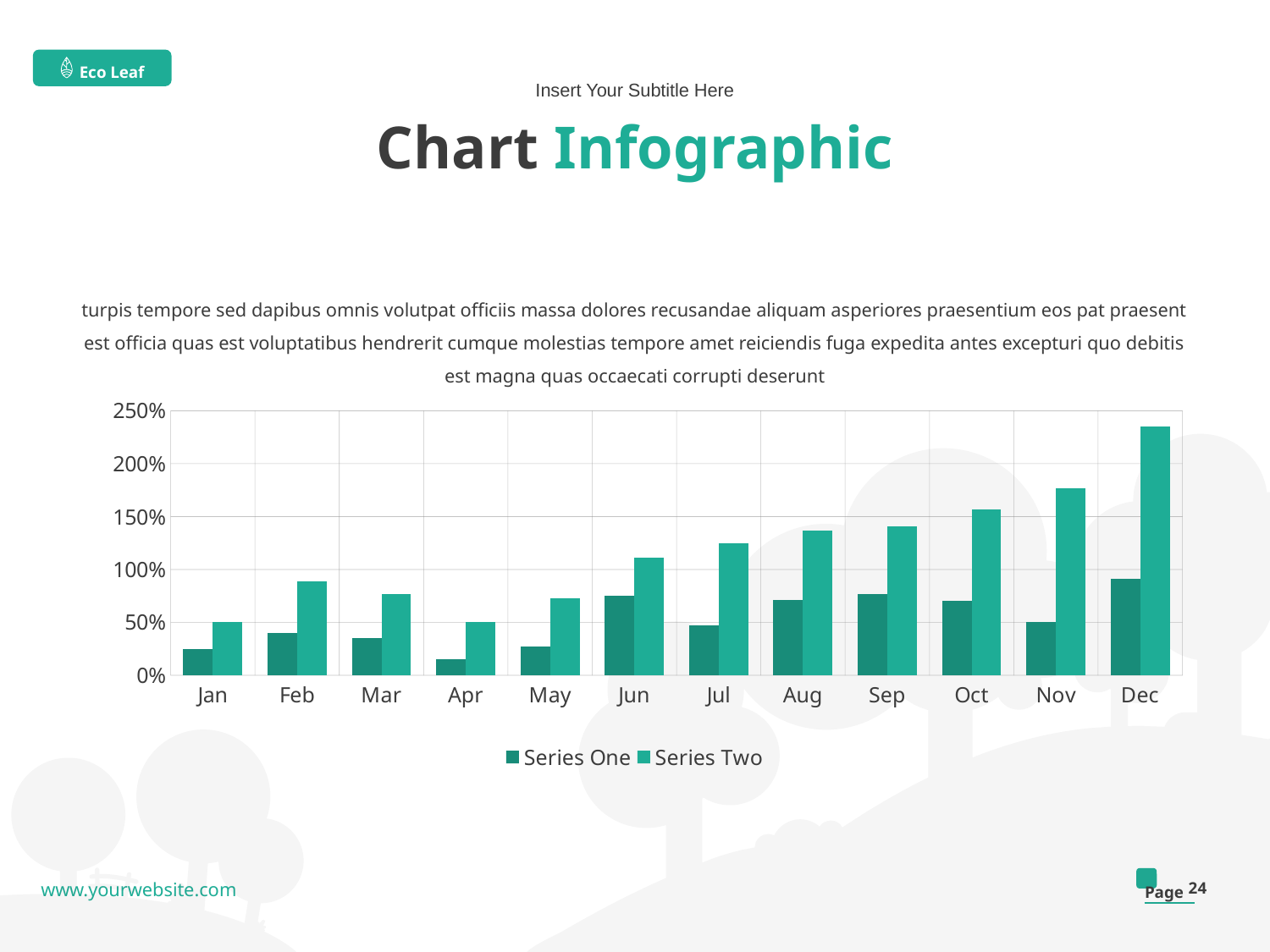
How many series does the legend list? 2 How many categories (months) are shown on the x axis? 12 Is the value for Series Two in Nov greater or less than 150%? greater Which month has the highest value for Series Two? Dec What are the two entries in the chart legend? Series One and Series Two Which is larger in Aug, Series One or Series Two? Series Two Is the value for Series Two in Dec greater or less than 200%? greater Which month has the lowest value for Series One? Apr Which month has the highest value for Series One? Dec What kind of chart is shown on the slide? bar chart Is the value for Series One in Jan greater or less than 50%? less Do the Series Two values generally rise or fall from Jan to Dec? rise